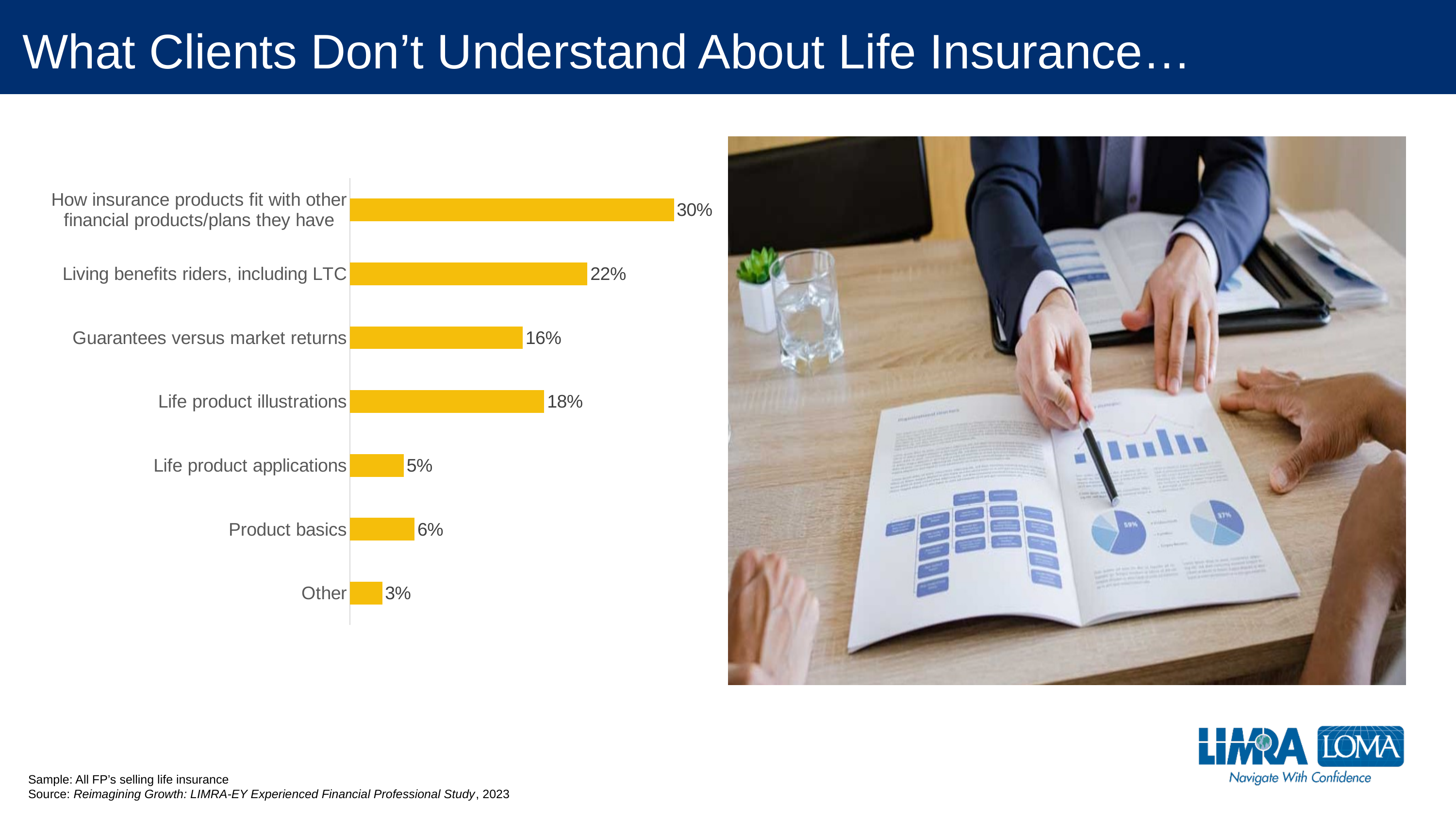
What is the difference between the highest and lowest values in the chart? 27% What kind of chart is shown on the slide? Bar chart Which is larger: "Product basics" or "Life product applications"? Product basics Which category has the highest value? How insurance products fit with other financial products/plans they have How many categories are shown in the chart? 7 What is the difference between the values for "Living benefits riders, including LTC" and "Guarantees versus market returns"? 6% Which category has the lowest value? Other Which is larger: "Life product illustrations" or "Guarantees versus market returns"? Life product illustrations What is the value for "Life product illustrations"? 18% What percentage is shown for "Living benefits riders, including LTC"? 22% What percentage is shown for "Product basics"? 6% What colour are the bars in the chart? Yellow